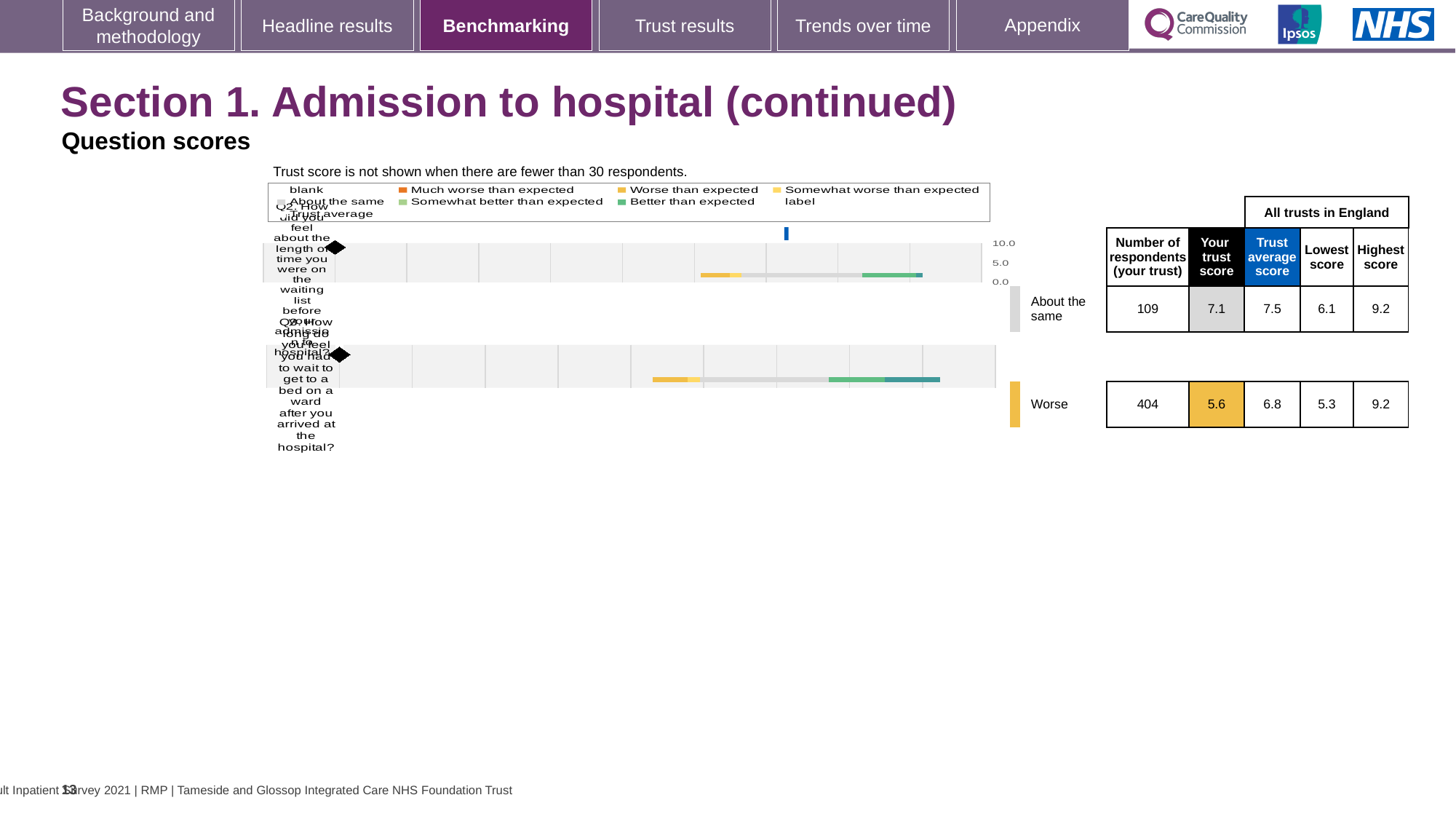
What is the trust score for Q2 (how did you feel about the length of time on the waiting list)? 7.1 What benchmark category is shown for Q3? Worse What is the difference between the trust average score and the trust score for Q3? 1.2 How many respondents from the trust answered Q2? 109 What is the lowest score across all trusts in England for Q3? 5.3 Which question has the higher trust score, Q2 or Q3? Q2 What kind of chart is used to show the question scores on this slide? bar chart What is the highest score across all trusts in England for Q2? 9.2 How many questions (Q2 and Q3) are charted on this slide? 2 What is the trust score for Q3 (how long did you feel you had to wait to get to a bed on a ward)? 5.6 What is the trust average score for all trusts in England for Q3? 6.8 What is the difference between the trust average score and the trust score for Q2? 0.4